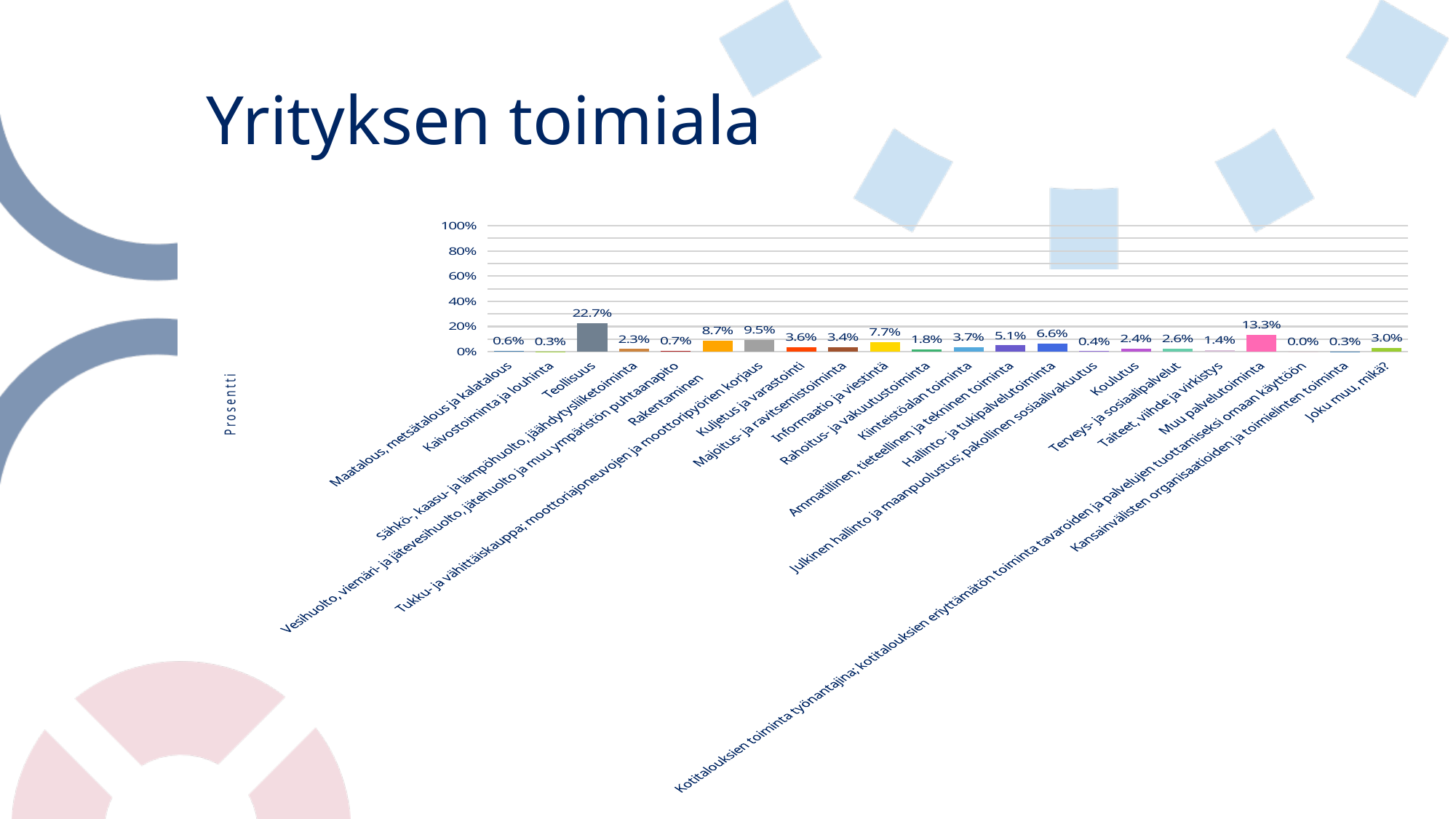
What kind of chart is shown on the slide? bar chart What is the value for Teollisuus? 22.7% What is the value for Rakentaminen? 8.7% What is the value for Informaatio ja viestintä? 7.7% What is the value for Muu palvelutoiminta? 13.3% How many categories are shown on the x axis? 22 Is the value for Teollisuus greater or less than 20%? greater What is the difference between the values for Teollisuus and Muu palvelutoiminta? 9.4% What is the value for Koulutus? 2.4% Which category has the highest value? Teollisuus Which category has the lowest value? Kotitalouksien toiminta työnantajina; kotitalouksien eriyttämätön toiminta tavaroiden ja palvelujen tuottamiseksi omaan käyttöön Which is larger, the value for Rakentaminen or the value for Hallinto- ja tukipalvelutoiminta? Rakentaminen